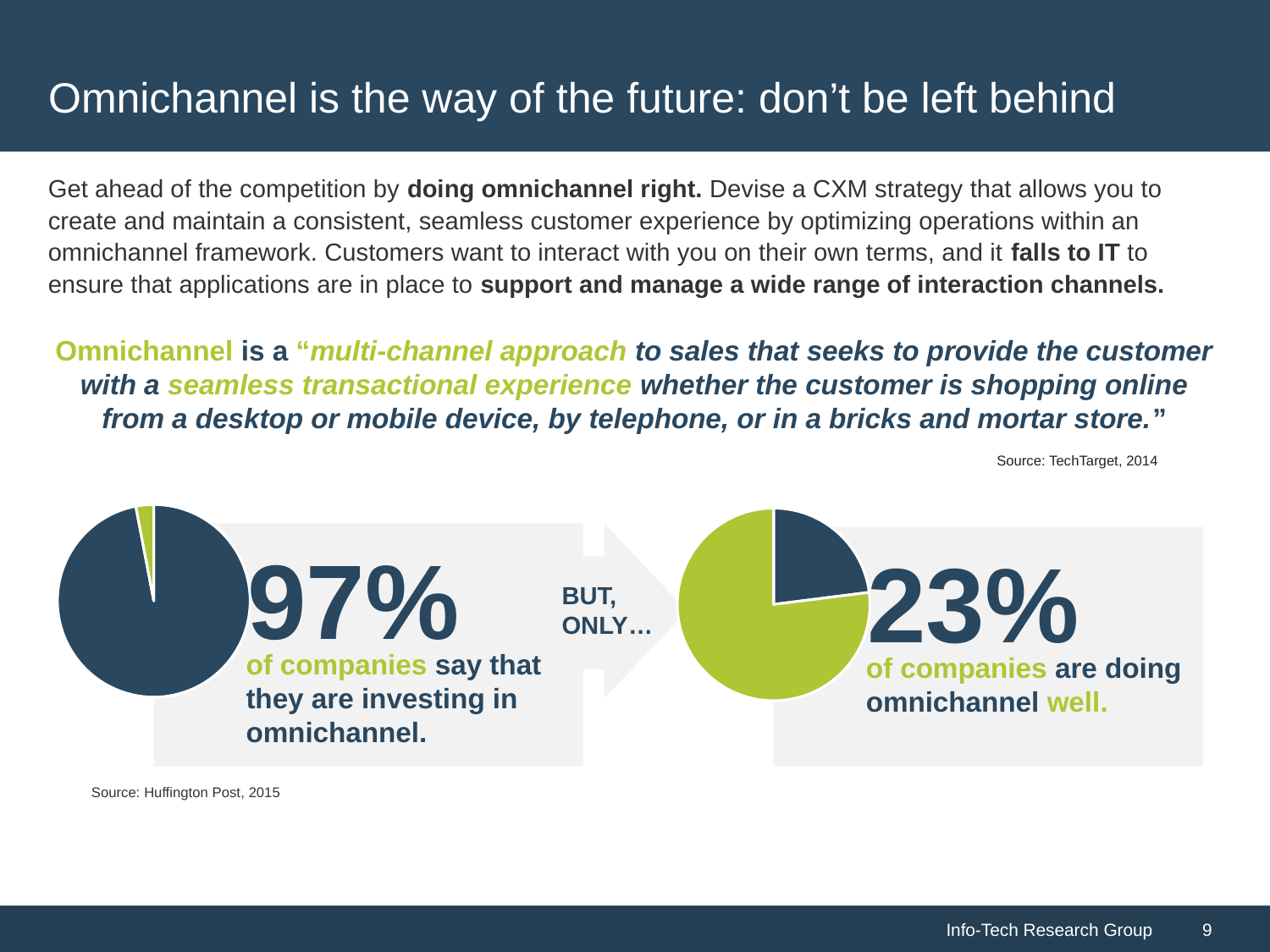
In the left pie chart, what share of the pie does the dark blue slice represent? 97% What is the difference between the 97% shown on the left pie chart and the 23% shown on the right pie chart? 74 percentage points Which is larger: the percentage of companies investing in omnichannel (left pie) or the percentage doing omnichannel well (right pie)? Investing in omnichannel (97%) According to the left pie chart, what percentage of companies say they are investing in omnichannel? 97% How many slices does the left pie chart have? 2 How many slices does the right pie chart have? 2 What colour is the largest slice in the right pie chart? Green How many pie charts are shown on the slide? 2 What kind of charts are shown at the bottom of the slide? Pie charts In the right pie chart, what share of the pie does the dark blue slice represent? 23% What source is cited below the two pie charts? Huffington Post, 2015 According to the right pie chart, what percentage of companies are doing omnichannel well? 23%